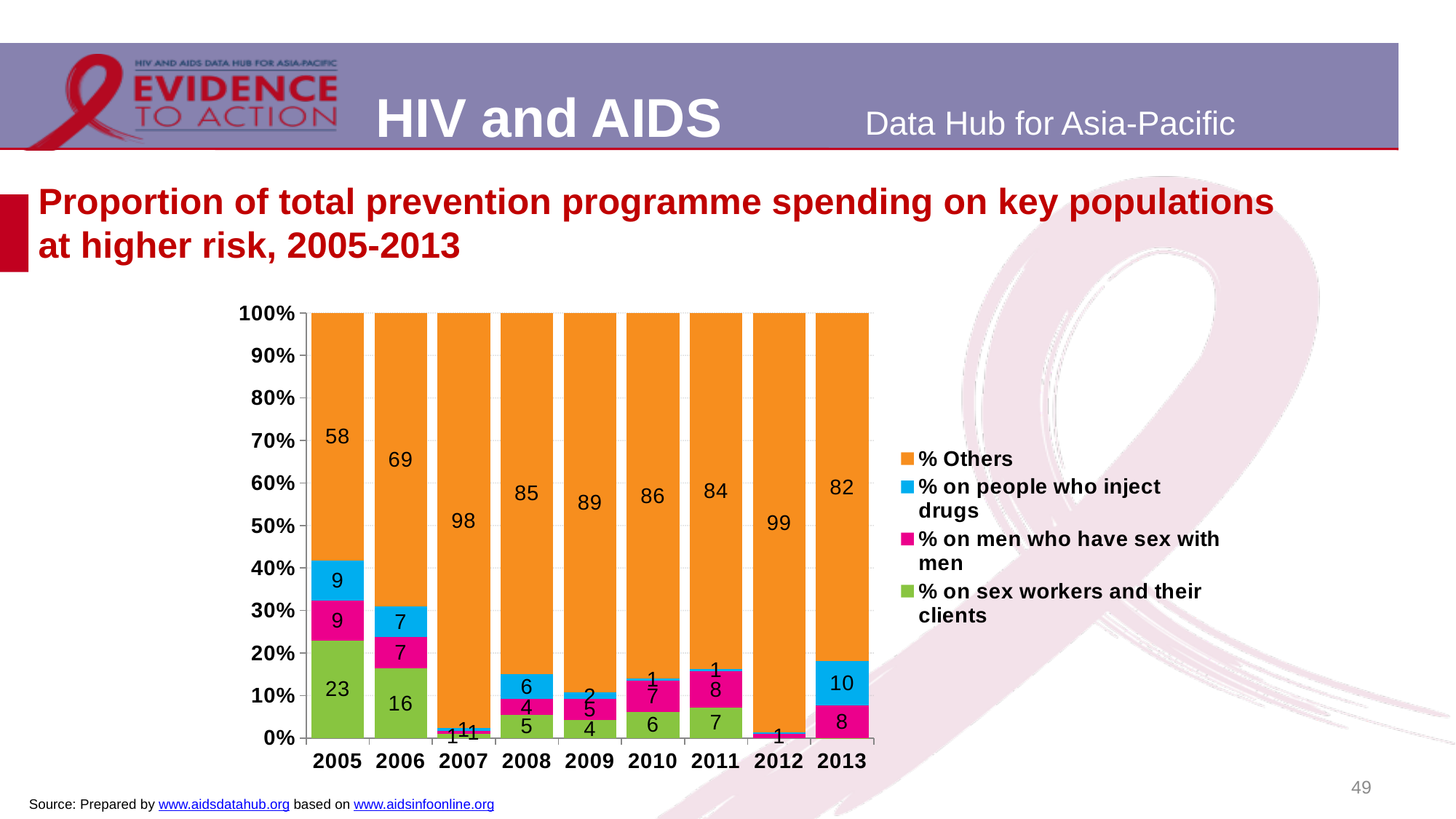
Does the % Others share rise or fall from 2005 to 2007? Rise What is the value for % Others in 2009? 89 What percentage of prevention spending went to sex workers and their clients in 2005? 23 How many years are shown on the x axis? 9 In which year is the % Others share the lowest? 2005 What is the value for % on men who have sex with men in 2011? 8 What is the value for % on people who inject drugs in 2013? 10 What kind of chart is shown on the slide? Stacked bar chart In which year is the % Others share the highest? 2012 Which is larger: the % on sex workers and their clients in 2005 or in 2006? 2005 What is the difference between the % Others value in 2006 and in 2005? 11 How many series does the legend list? 4